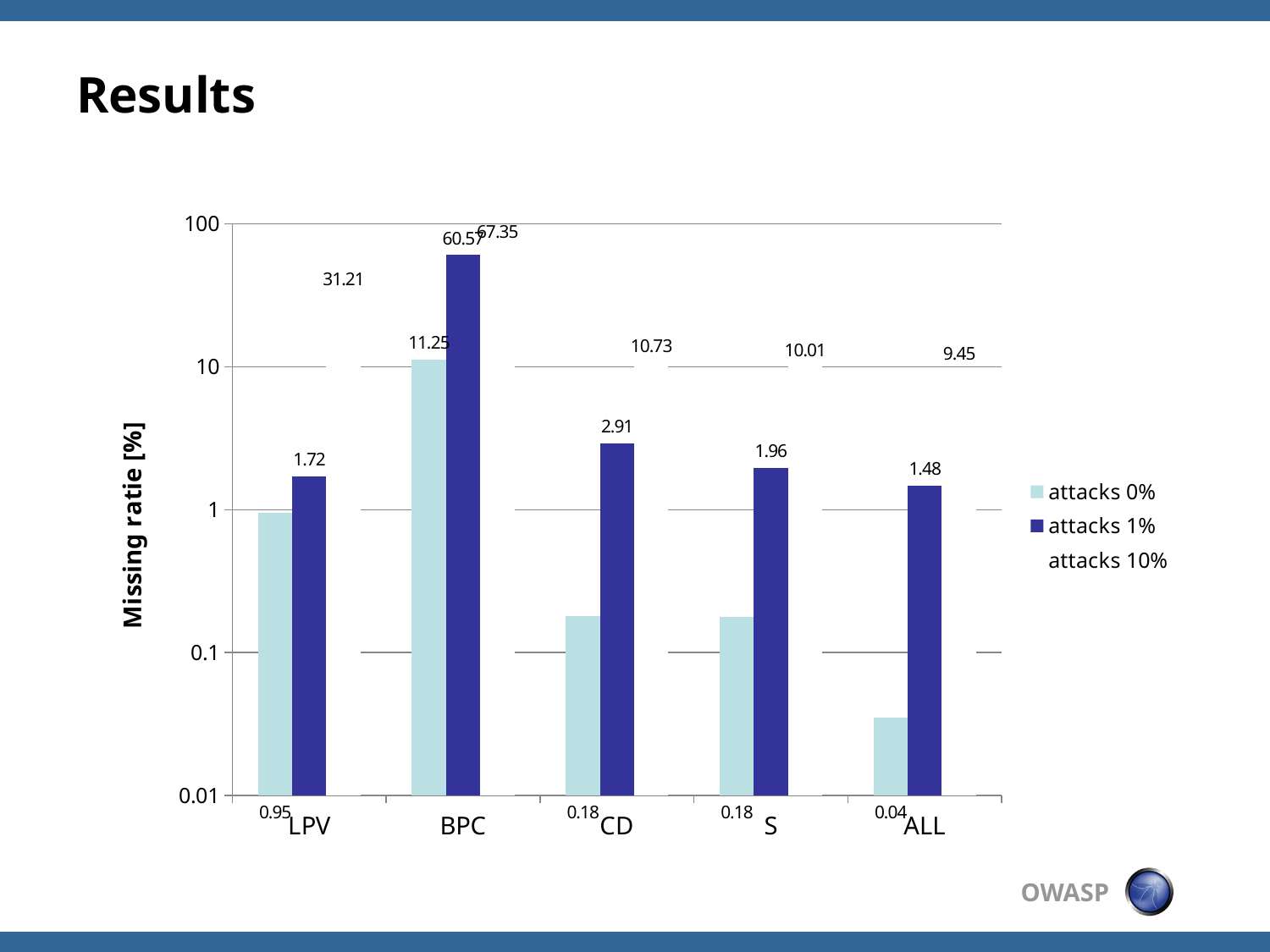
What kind of chart is shown on the slide? Bar chart What is the label of the y axis? Missing ratie [%] How many series does the legend list? 3 Which category has the lowest value in the attacks 0% series? ALL What is the value for CD in the attacks 1% series? 2.91 How many categories are shown on the x axis? 5 What is the value for BPC in the attacks 1% series? 60.57 Which category has the highest value in the attacks 1% series? BPC Which is larger: the attacks 10% value for CD or for S? CD What is the difference between the attacks 1% values for BPC and LPV? 58.85 What is the value for ALL in the attacks 10% series? 9.45 What is the value for LPV in the attacks 0% series? 0.95